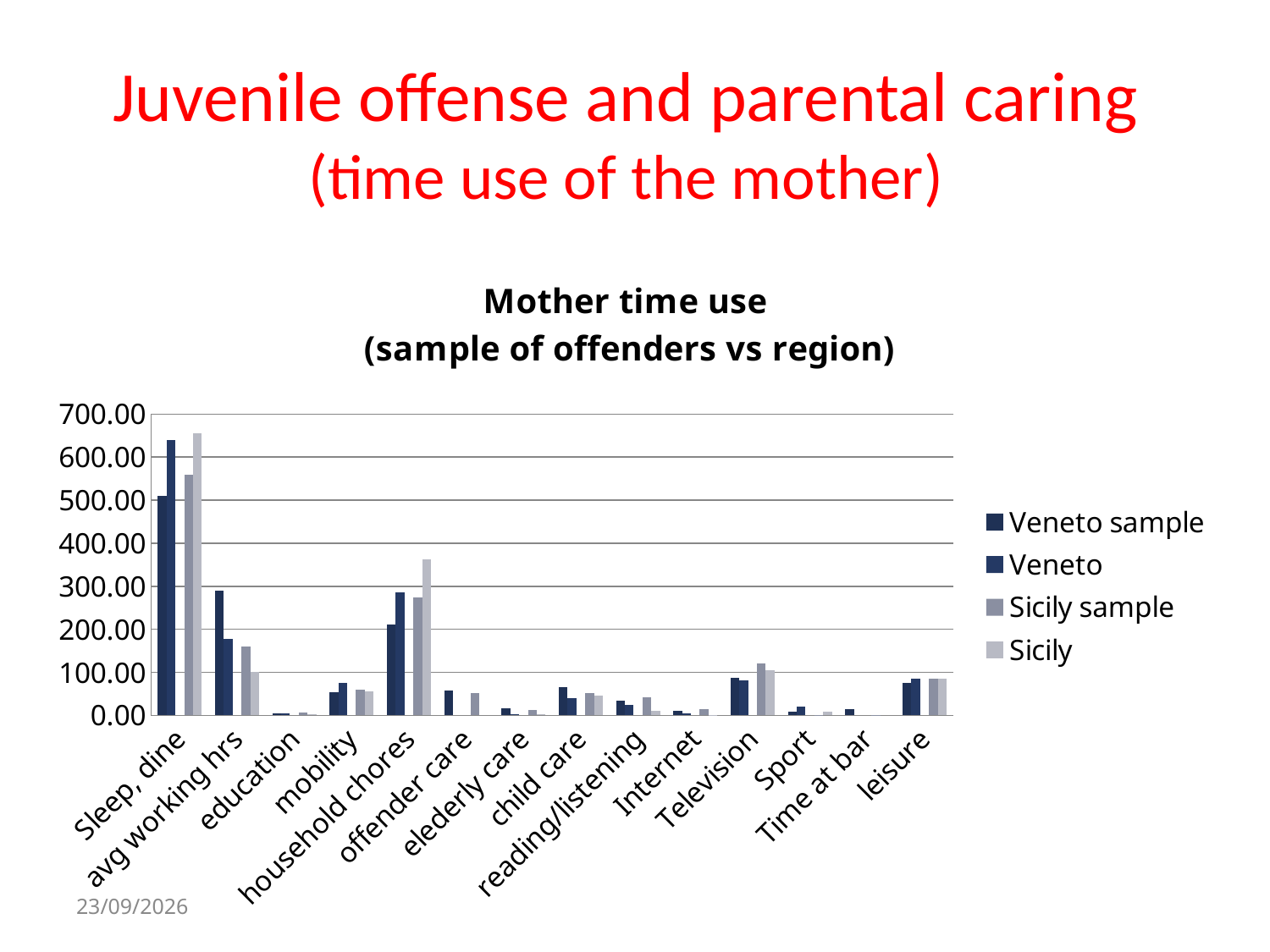
How many categories are shown along the x axis of the chart? 14 What is the title of the chart? Mother time use (sample of offenders vs region) Which category has the highest values in the chart? Sleep, dine For Sleep, dine, which is larger: the Veneto value or the Veneto sample value? Veneto Which series has the highest value for avg working hrs? Veneto sample Is the Sicily sample value for Television greater or less than 100? greater Which series has the highest value for household chores? Sicily Is the Veneto value for Sleep, dine greater or less than 600? greater Is the Sicily value for household chores greater or less than 300? greater How many series does the chart legend list? 4 What kind of chart is shown on the slide? bar chart